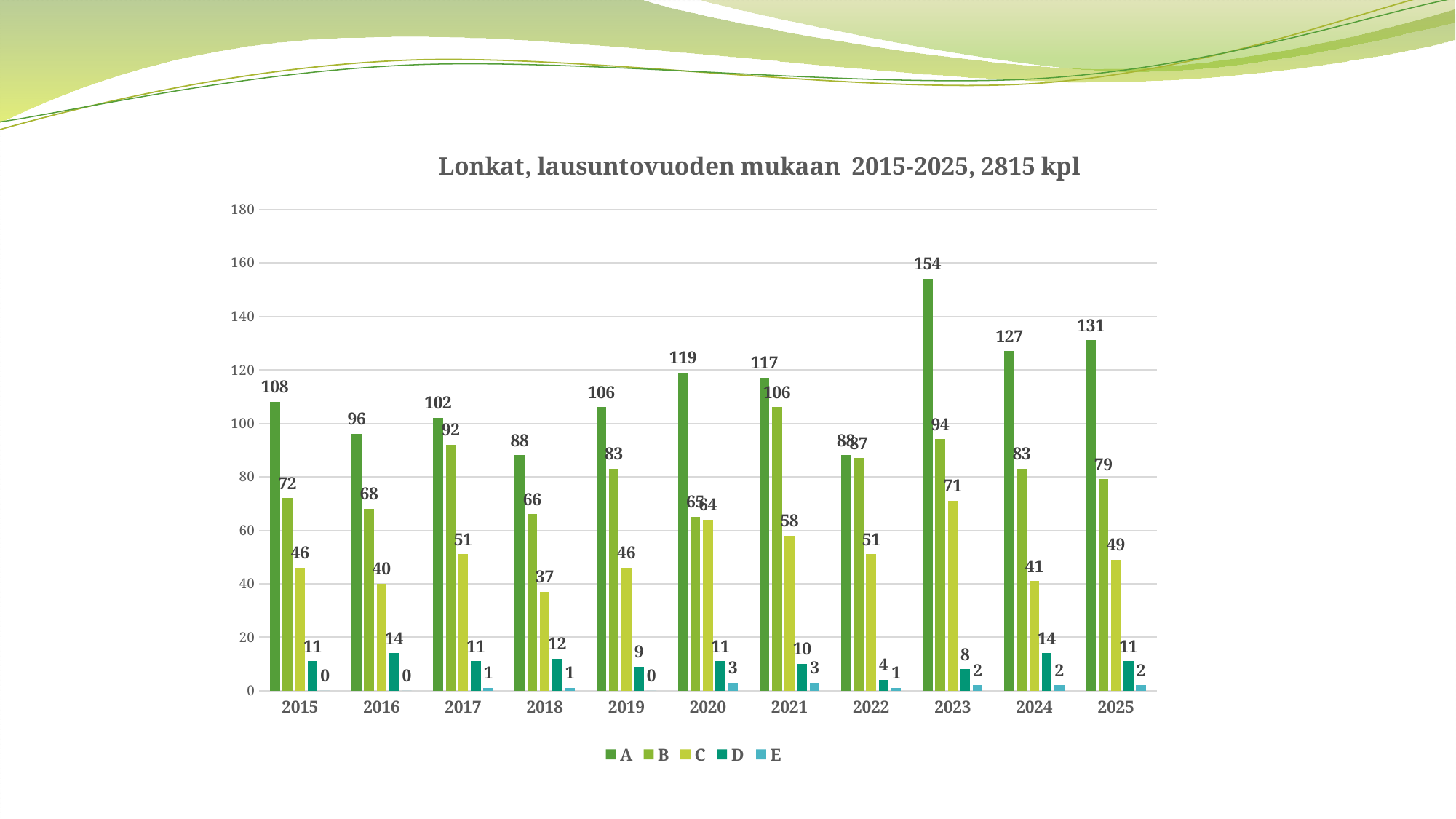
What kind of chart is shown on the slide? Bar chart In which year is the value for series C lowest? 2018 What is the difference between the values for series A and series B in 2021? 11 In which year is the value for series A highest? 2023 How many series does the legend list? 5 What is the title of the chart? Lonkat, lausuntovuoden mukaan 2015-2025, 2815 kpl How many years are shown on the x axis? 11 What is the value for series A in 2023? 154 Is the value for series A in 2024 greater or less than 120? greater What is the value for series C in 2020? 64 Which is larger, the value for series B in 2017 or the value for series B in 2019? 2017 What is the value for series D in 2016? 14